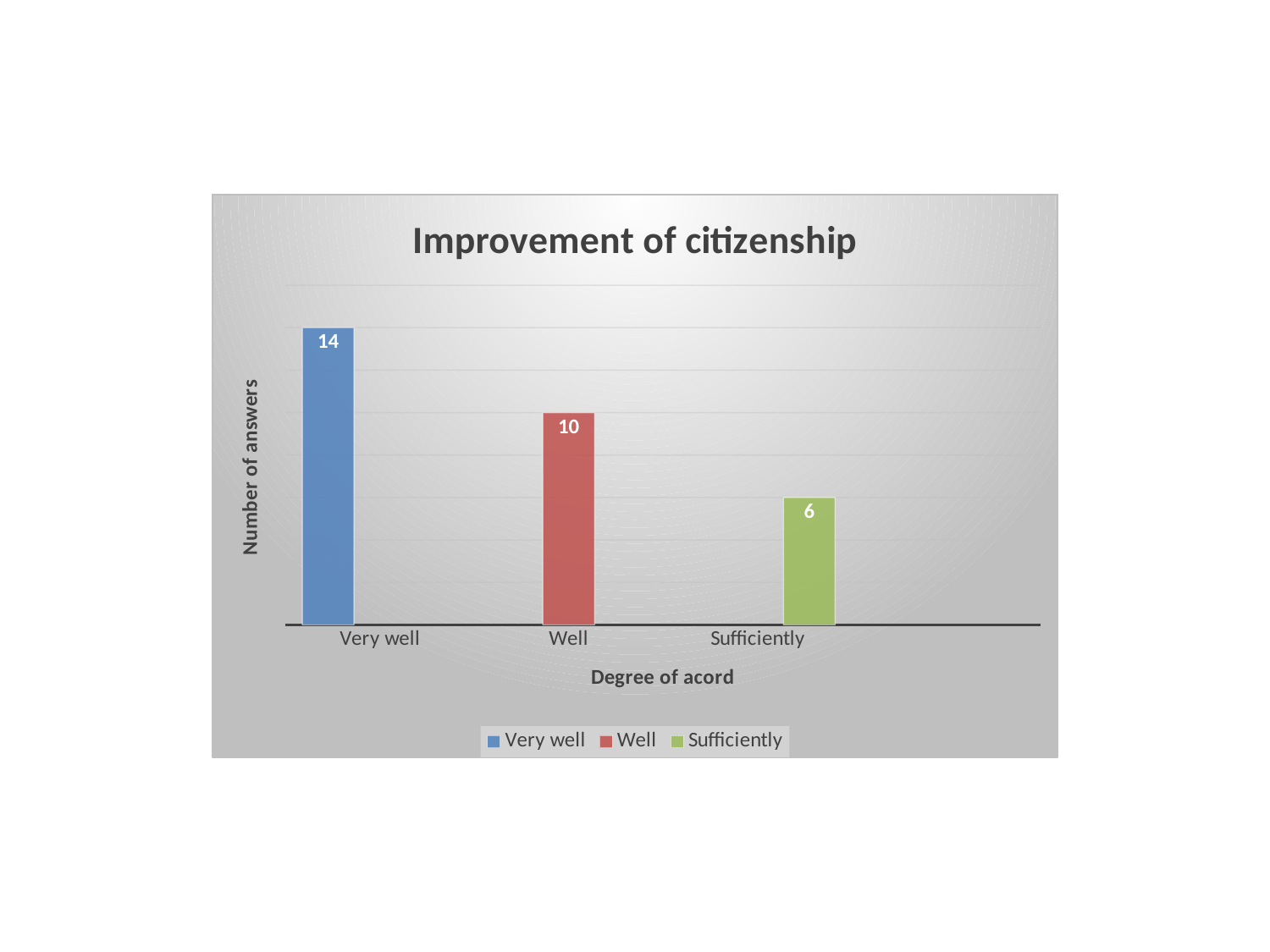
How many categories are shown on the x axis? 3 What is the difference between the number of answers for "Very well" and "Well"? 4 Which has more answers, "Well" or "Sufficiently"? Well What is the number of answers for "Well"? 10 How many entries does the legend list? 3 What is the number of answers for "Sufficiently"? 6 What is the difference between the number of answers for "Well" and "Sufficiently"? 4 Do the values rise or fall from left to right along the x axis? Fall What kind of chart is shown? Bar chart Which category has the lowest number of answers? Sufficiently What is the number of answers for "Very well"? 14 Which category has the highest number of answers? Very well